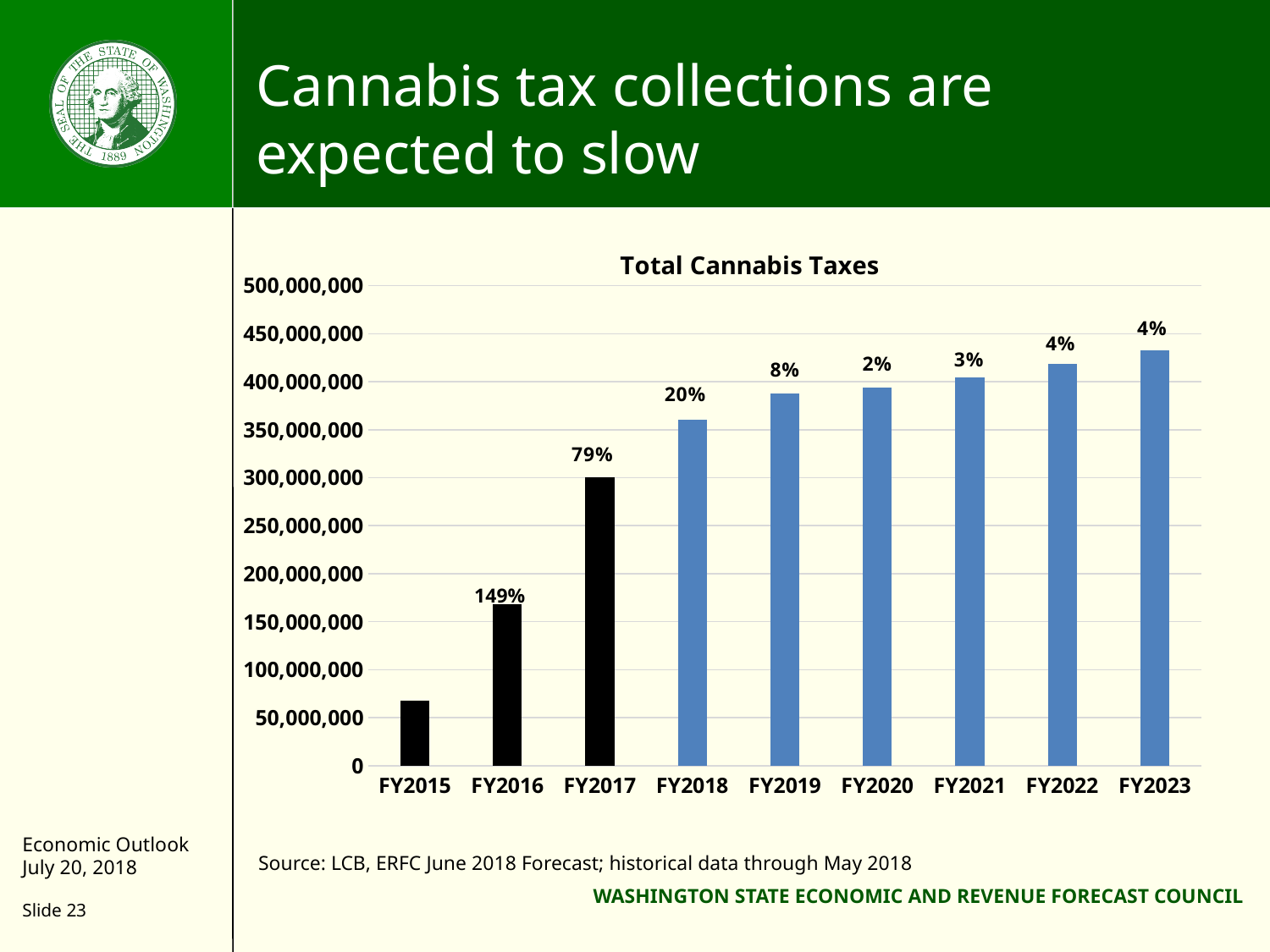
Which fiscal year has the shortest bar? FY2015 What percentage label is printed above the FY2016 bar? 149% What percentage label is printed above the FY2018 bar? 20% How many fiscal years are plotted on the x axis? 9 What kind of chart is shown on the slide? Bar chart What percentage label is printed above the FY2021 bar? 3% Is the value for FY2018 greater or less than 350,000,000? greater Which fiscal year has the tallest bar? FY2023 Is the value for FY2015 greater or less than 100,000,000? less Which is larger, the bar for FY2016 or the bar for FY2017? FY2017 Do the bar values rise or fall from FY2015 to FY2023? Rise What is the title of the chart? Total Cannabis Taxes